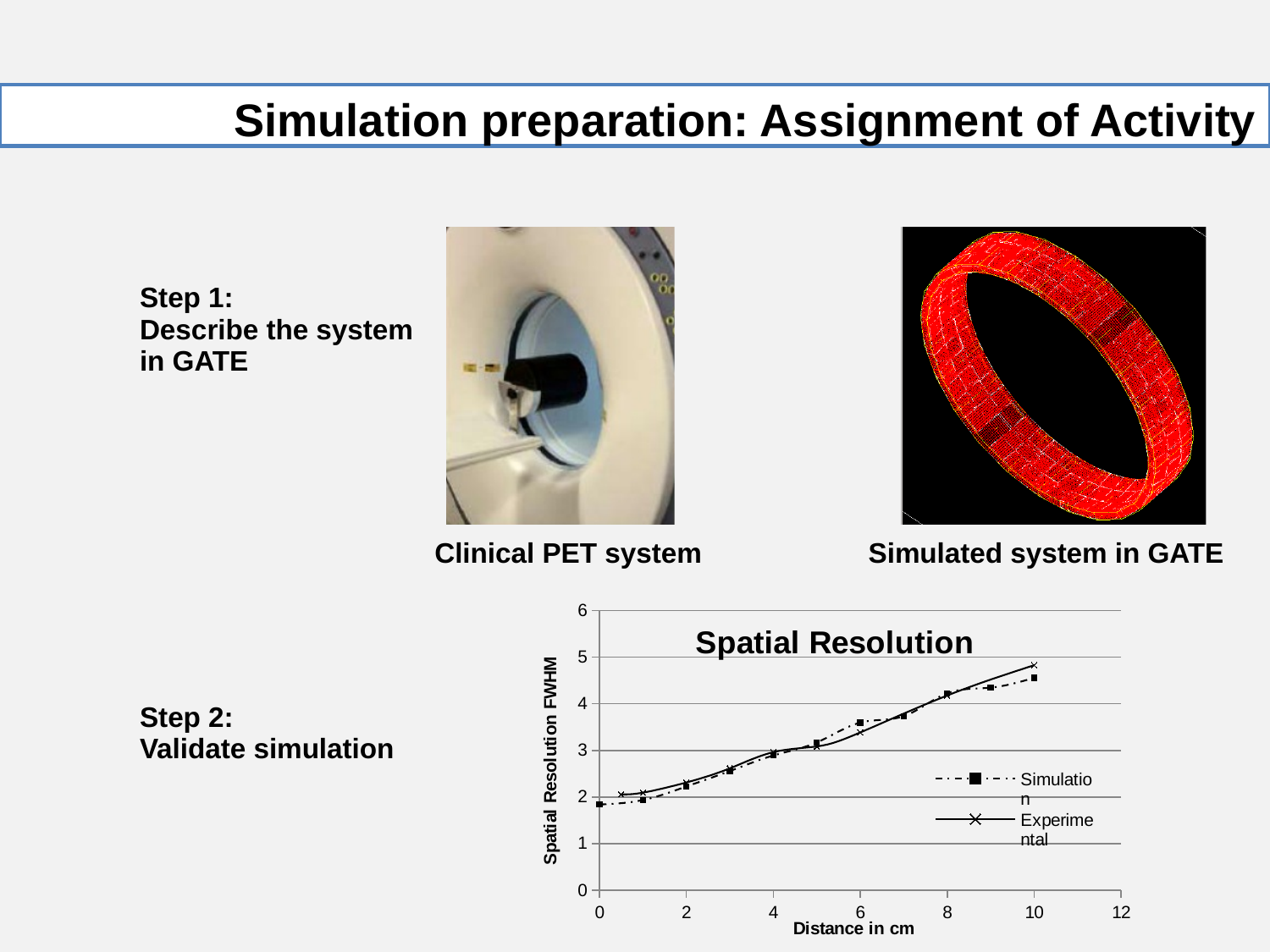
What kind of chart is shown under Step 2 on the slide? line chart Is the Simulation value at a distance of 10 cm greater or less than 4? greater Is the Experimental value at a distance of 8 cm greater or less than 5? less At which distance does the Experimental series reach its highest value? 10 What is the label of the x axis of the chart? Distance in cm Is the Experimental value at a distance of 6 cm greater or less than 3? greater What is the title of the chart on the slide? Spatial Resolution At a distance of 10 cm, which series has the larger value, Simulation or Experimental? Experimental Do the Experimental values rise or fall as distance increases along the x axis? rise How many series does the chart's legend list? 2 Do the Simulation values rise or fall as distance increases along the x axis? rise